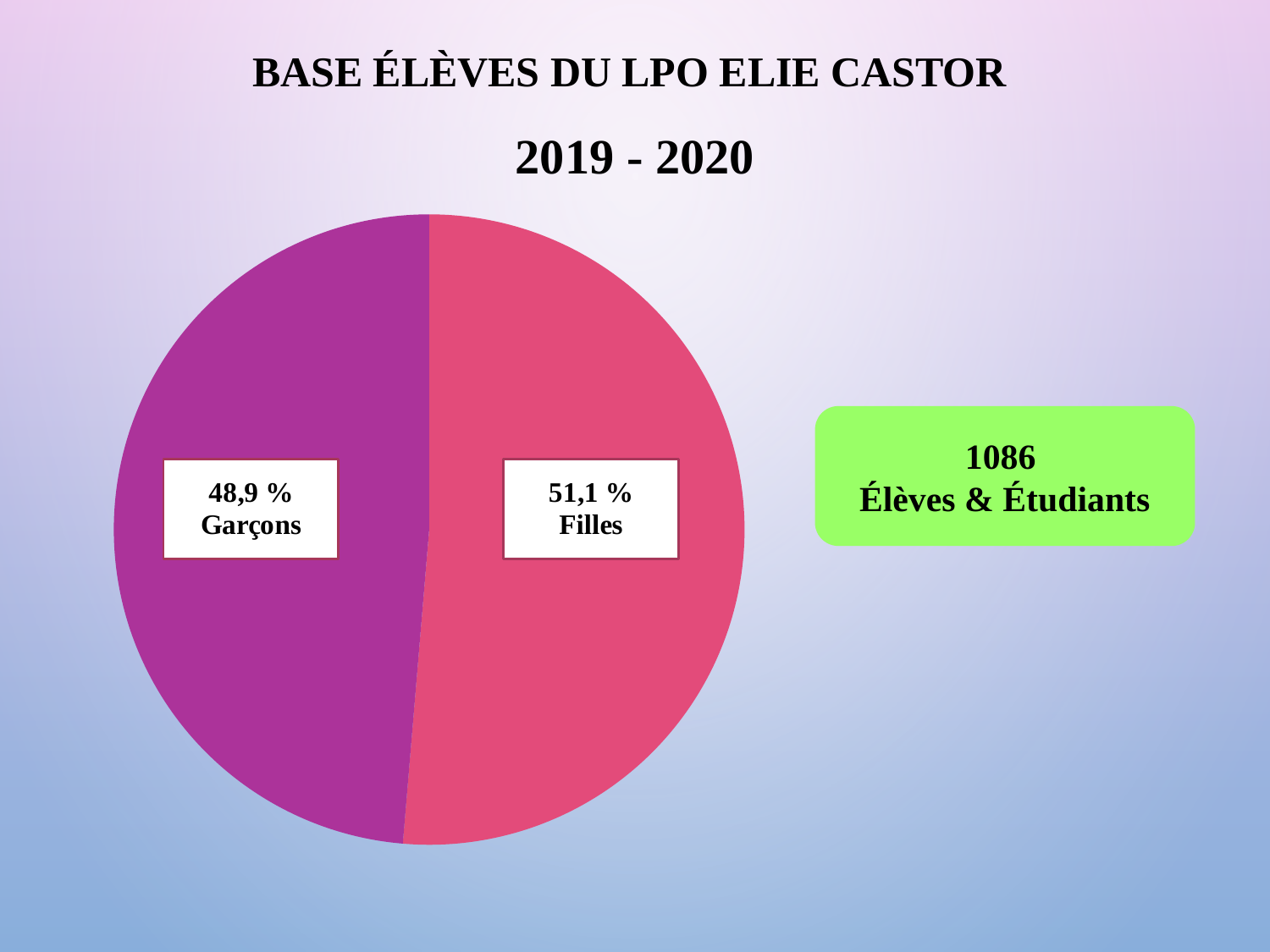
Is the share for Filles greater or less than 50%? greater What is the difference in percentage points between the Filles and Garçons shares? 2,2 % What colour is the Garçons slice? purple Which slice is larger, Garçons or Filles? Filles Which category has the smallest share of the pie? Garçons Which category has the largest share of the pie? Filles What total number of Élèves & Étudiants is shown next to the chart? 1086 What is the title shown above the chart? BASE ÉLÈVES DU LPO ELIE CASTOR 2019 - 2020 How many slices does the pie chart have? 2 What kind of chart is shown on the slide? pie chart What share of the pie is labelled Garçons? 48,9 % What share of the pie is labelled Filles? 51,1 %